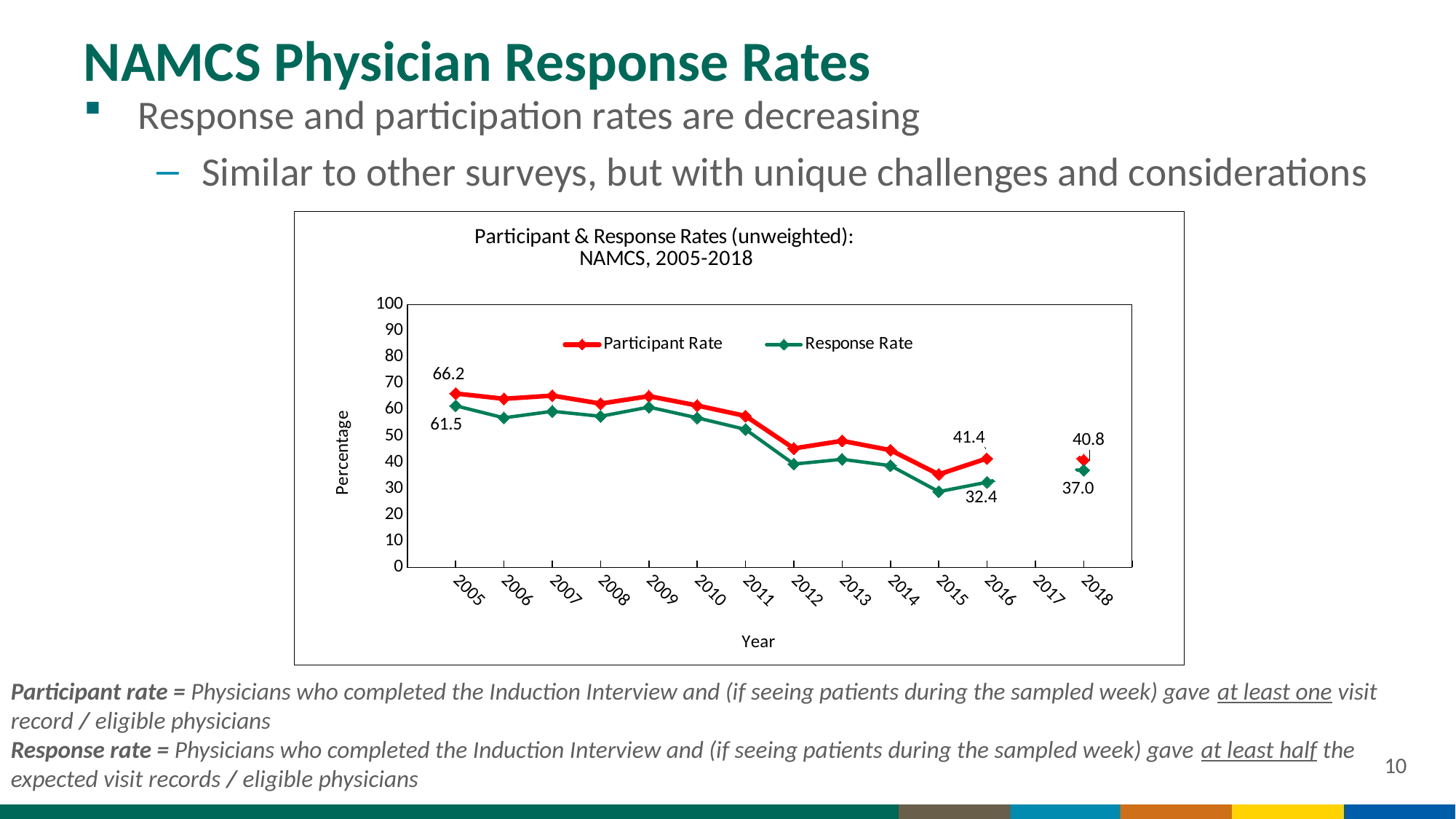
What is the Response Rate in 2018? 37.0 What is the Participant Rate in 2016? 41.4 What is the Participant Rate in 2005? 66.2 What is the Response Rate in 2005? 61.5 Do the Participant Rate values generally rise or fall from 2005 to 2018? Fall What is the difference between the Participant Rate and the Response Rate in 2005? 4.7 What is the title of the chart? Participant & Response Rates (unweighted): NAMCS, 2005-2018 What is the Participant Rate in 2018? 40.8 What type of chart is shown on the slide? Line chart How many series does the chart legend list? 2 What is the Response Rate in 2016? 32.4